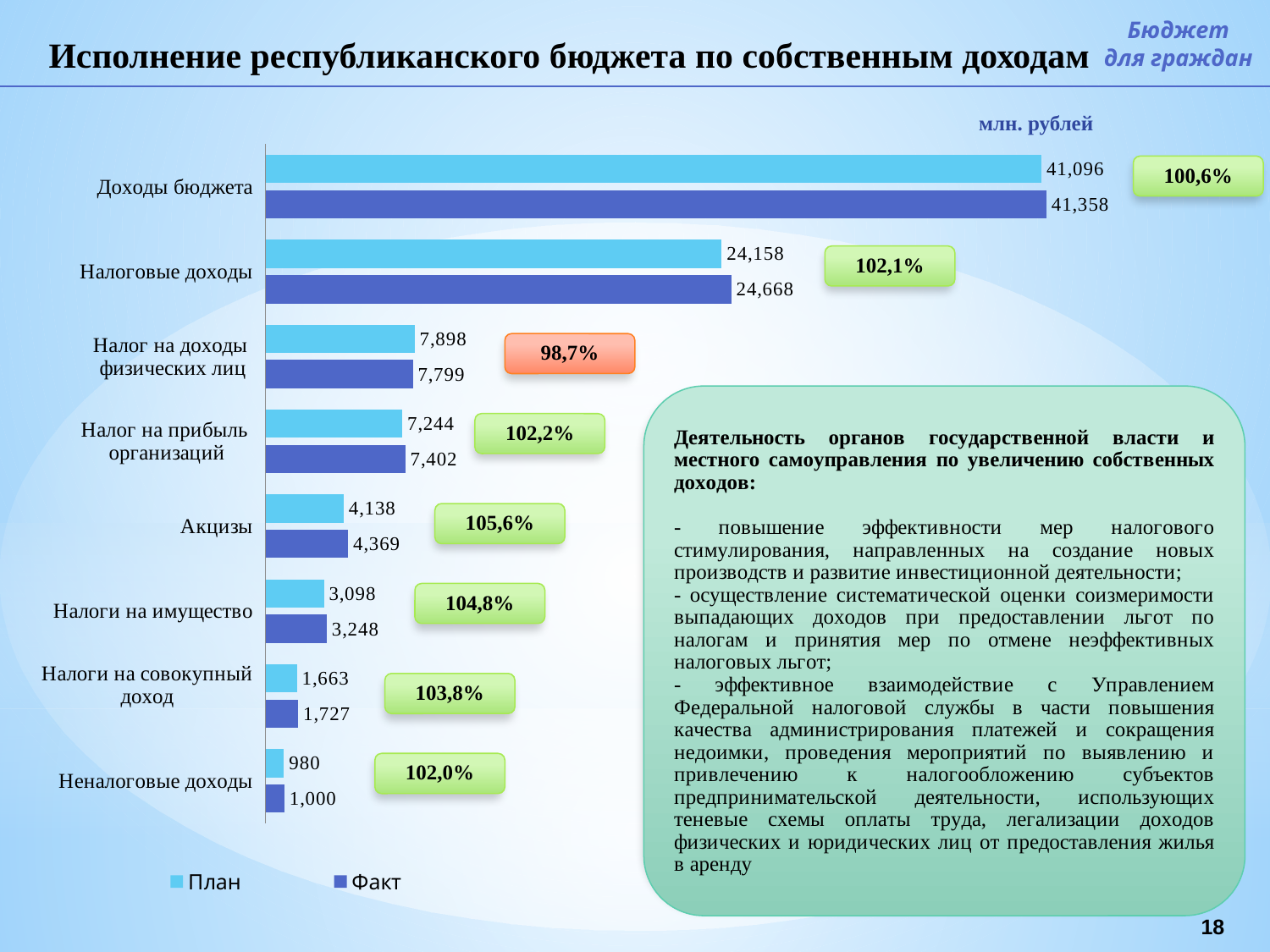
What is the План value for Неналоговые доходы? 980 What is the План value for Налоговые доходы? 24,158 What is the Факт value for Акцизы? 4,369 Which category has the highest Факт value? Доходы бюджета What is the difference between the Факт and План values for Доходы бюджета? 262 How many series does the legend list? 2 What kind of chart is shown on the slide? Bar chart What is the Факт value for Налог на доходы физических лиц? 7,799 What is the difference between the План and Факт values for Налог на доходы физических лиц? 99 Which is larger for Налог на прибыль организаций, the План value or the Факт value? Факт How many categories are shown on the chart? 8 Which category has the lowest План value? Неналоговые доходы